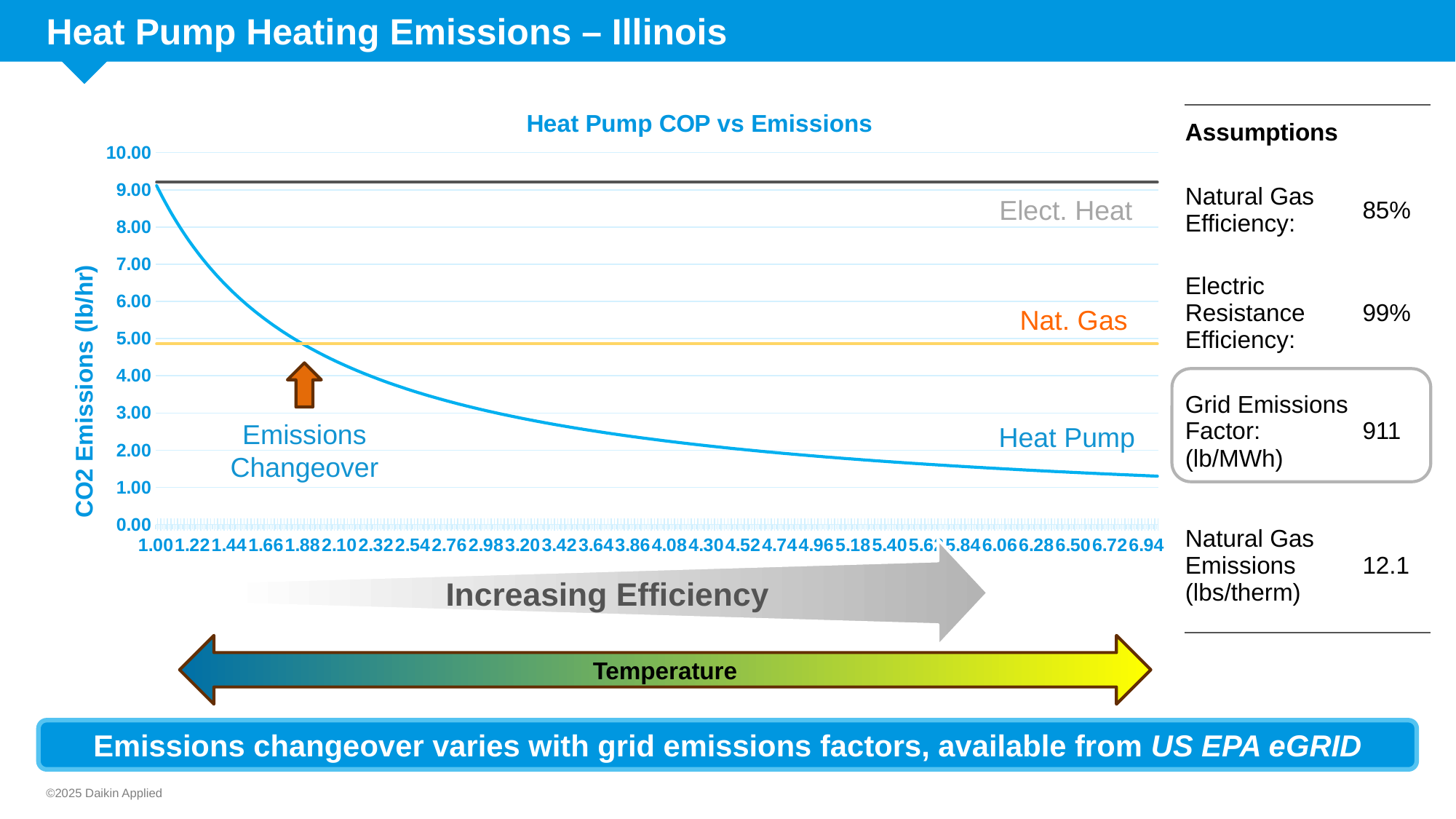
What kind of chart is shown on the slide? line chart Which series has the highest emissions across the whole chart? Elect. Heat At COP 6.94, which is larger, the Heat Pump value or the Nat. Gas value? Nat. Gas What is the label on the vertical axis of the chart? CO2 Emissions (lb/hr) Is the value for Elect. Heat greater or less than 8.00? greater Is the value for Nat. Gas greater or less than 6.00? less Which series has the lowest emissions at the right end of the chart (COP 6.94)? Heat Pump Is the Heat Pump value at COP 6.94 greater or less than 2.00? less What is the title of the chart? Heat Pump COP vs Emissions Do the Heat Pump emissions rise or fall as COP increases along the x axis? fall Which is larger, the Elect. Heat value or the Nat. Gas value? Elect. Heat How many series are plotted on the chart? 3